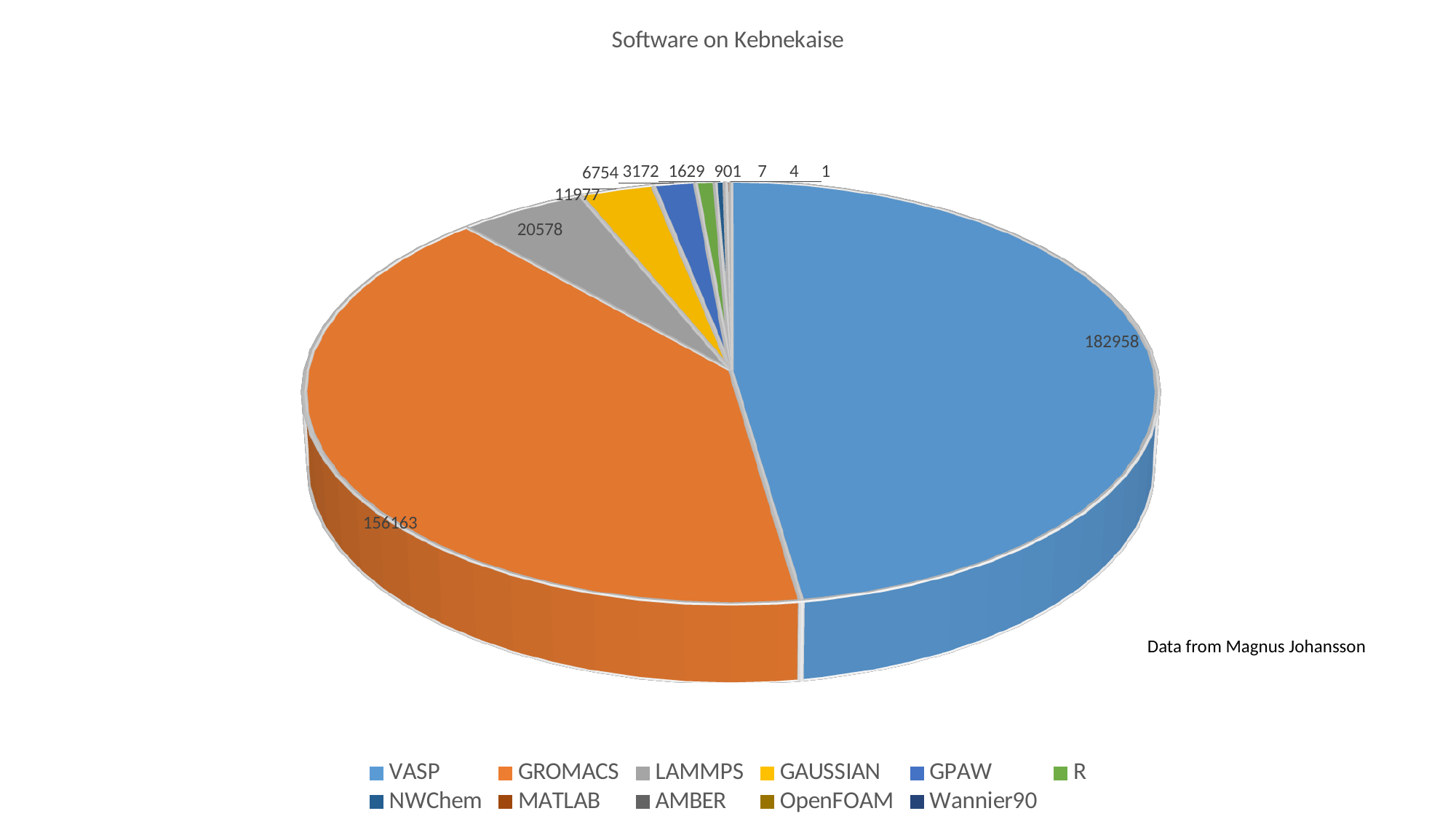
What is the title of the chart? Software on Kebnekaise What kind of chart is shown on the slide? Pie chart What is the value for GAUSSIAN? 11977 What is the value for GPAW? 6754 Which is larger, the value for LAMMPS or the value for GAUSSIAN? LAMMPS What is the difference between the values for LAMMPS and GAUSSIAN? 8601 What is the value for LAMMPS? 20578 What is the difference between the values for VASP and GROMACS? 26795 What is the value for GROMACS? 156163 Which software has the largest slice of the pie? VASP What is the value for VASP? 182958 How many software packages does the legend list? 11